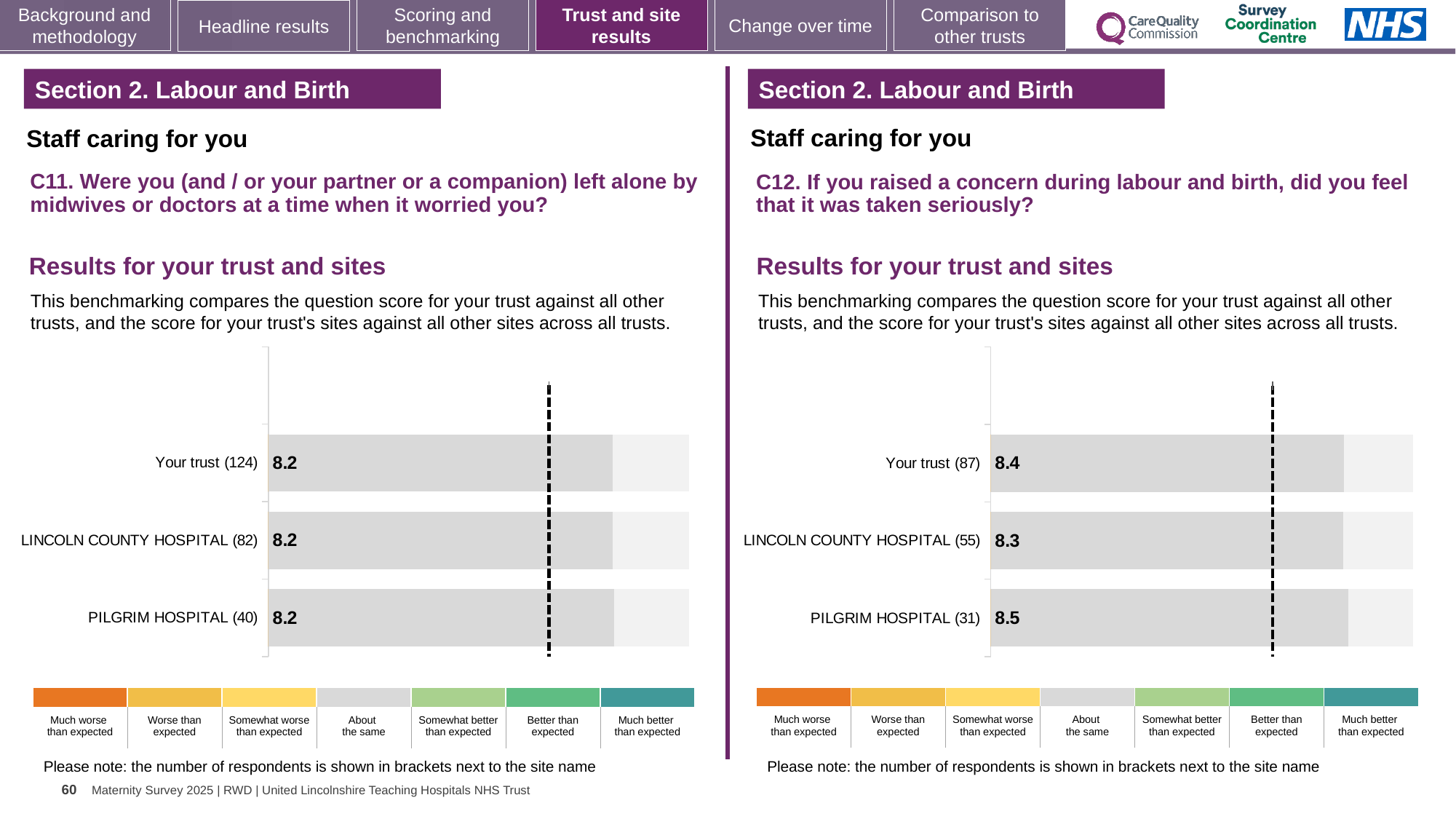
In the C12 chart on the right, what is the score for LINCOLN COUNTY HOSPITAL (55)? 8.3 In the C12 chart on the right, what is the score for Your trust (87)? 8.4 In the C11 chart on the left, what is the score for PILGRIM HOSPITAL (40)? 8.2 How many respondents are shown in brackets for Your trust in the C11 chart on the left? 124 In the C12 chart on the right, which site has the highest score? PILGRIM HOSPITAL (31) In the C12 chart on the right, what is the score for PILGRIM HOSPITAL (31)? 8.5 What type of chart is used in the C12 chart on the right? Bar chart In the C12 chart on the right, what is the difference between the scores for PILGRIM HOSPITAL (31) and LINCOLN COUNTY HOSPITAL (55)? 0.2 How many bars are shown in the C11 chart on the left? 3 In the C12 chart on the right, which site has the lowest score? LINCOLN COUNTY HOSPITAL (55) In the C12 chart on the right, which has the larger score, Your trust (87) or PILGRIM HOSPITAL (31)? PILGRIM HOSPITAL (31) In the C11 chart on the left, what is the score for Your trust (124)? 8.2